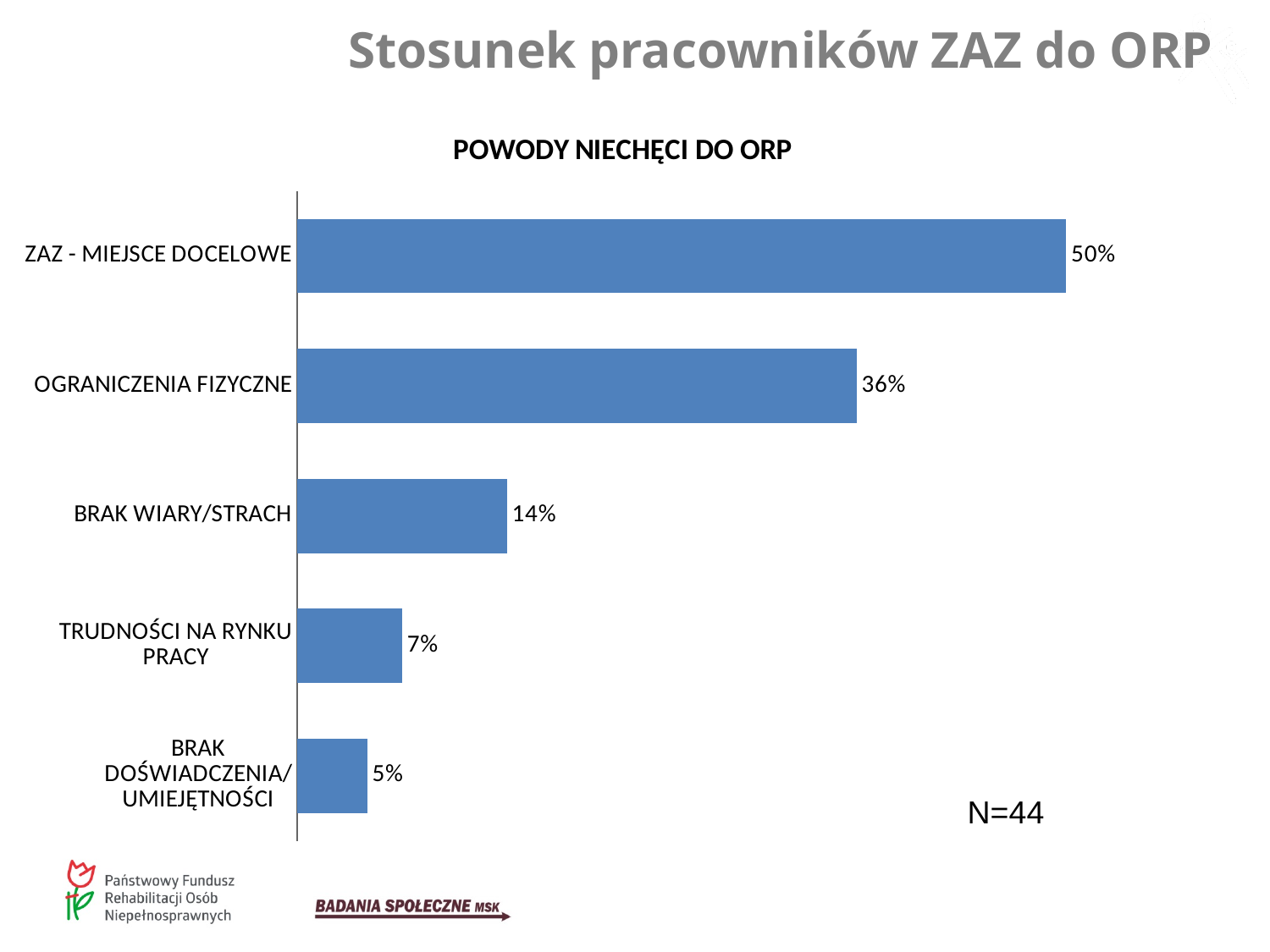
What is the difference between the values for ZAZ - MIEJSCE DOCELOWE and OGRANICZENIA FIZYCZNE? 14% What is the value for BRAK WIARY/STRACH? 14% How many categories are shown in the chart? 5 Which category has the lowest value? BRAK DOŚWIADCZENIA/UMIEJĘTNOŚCI What is the value for TRUDNOŚCI NA RYNKU PRACY? 7% What is the title of the chart? POWODY NIECHĘCI DO ORP What kind of chart is shown on the slide? bar chart Which category has the highest value? ZAZ - MIEJSCE DOCELOWE What is the value for BRAK DOŚWIADCZENIA/UMIEJĘTNOŚCI? 5% What is the value for ZAZ - MIEJSCE DOCELOWE? 50% Which is larger, the value for BRAK WIARY/STRACH or the value for TRUDNOŚCI NA RYNKU PRACY? BRAK WIARY/STRACH What is the value for OGRANICZENIA FIZYCZNE? 36%